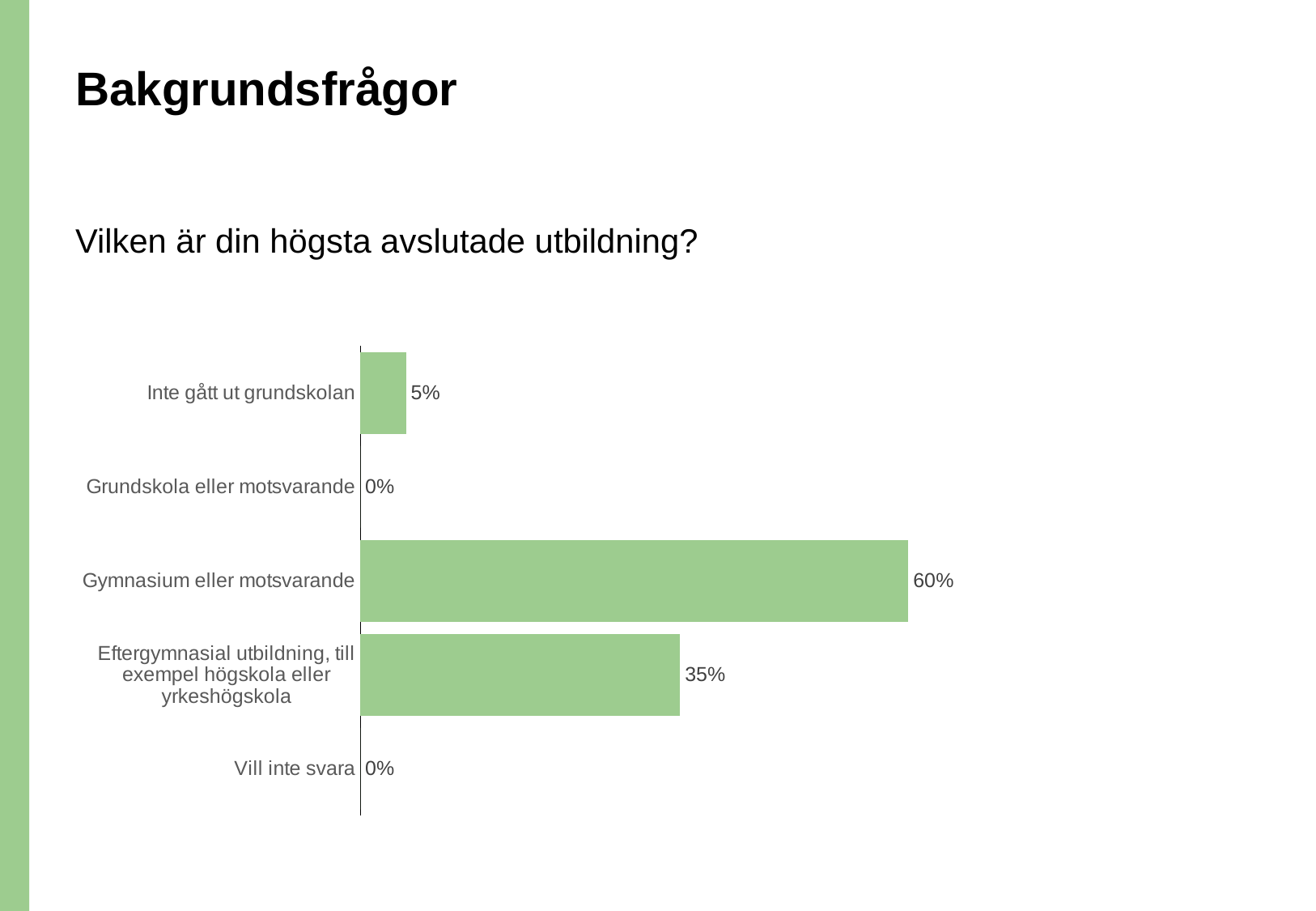
What is the value for "Eftergymnasial utbildning, till exempel högskola eller yrkeshögskola"? 35% How many categories have a value of 0%? 2 How many categories are shown in the chart? 5 What is the value for "Inte gått ut grundskolan"? 5% What is the value for "Vill inte svara"? 0% Which is larger, the value for "Inte gått ut grundskolan" or the value for "Eftergymnasial utbildning, till exempel högskola eller yrkeshögskola"? Eftergymnasial utbildning, till exempel högskola eller yrkeshögskola What question does the chart on the slide present results for? Vilken är din högsta avslutade utbildning? What is the value for "Gymnasium eller motsvarande"? 60% What kind of chart is shown on the slide? Bar chart What is the difference between the values for "Gymnasium eller motsvarande" and "Eftergymnasial utbildning, till exempel högskola eller yrkeshögskola"? 25% Which category has the highest value? Gymnasium eller motsvarande What is the difference between the values for "Eftergymnasial utbildning, till exempel högskola eller yrkeshögskola" and "Inte gått ut grundskolan"? 30%